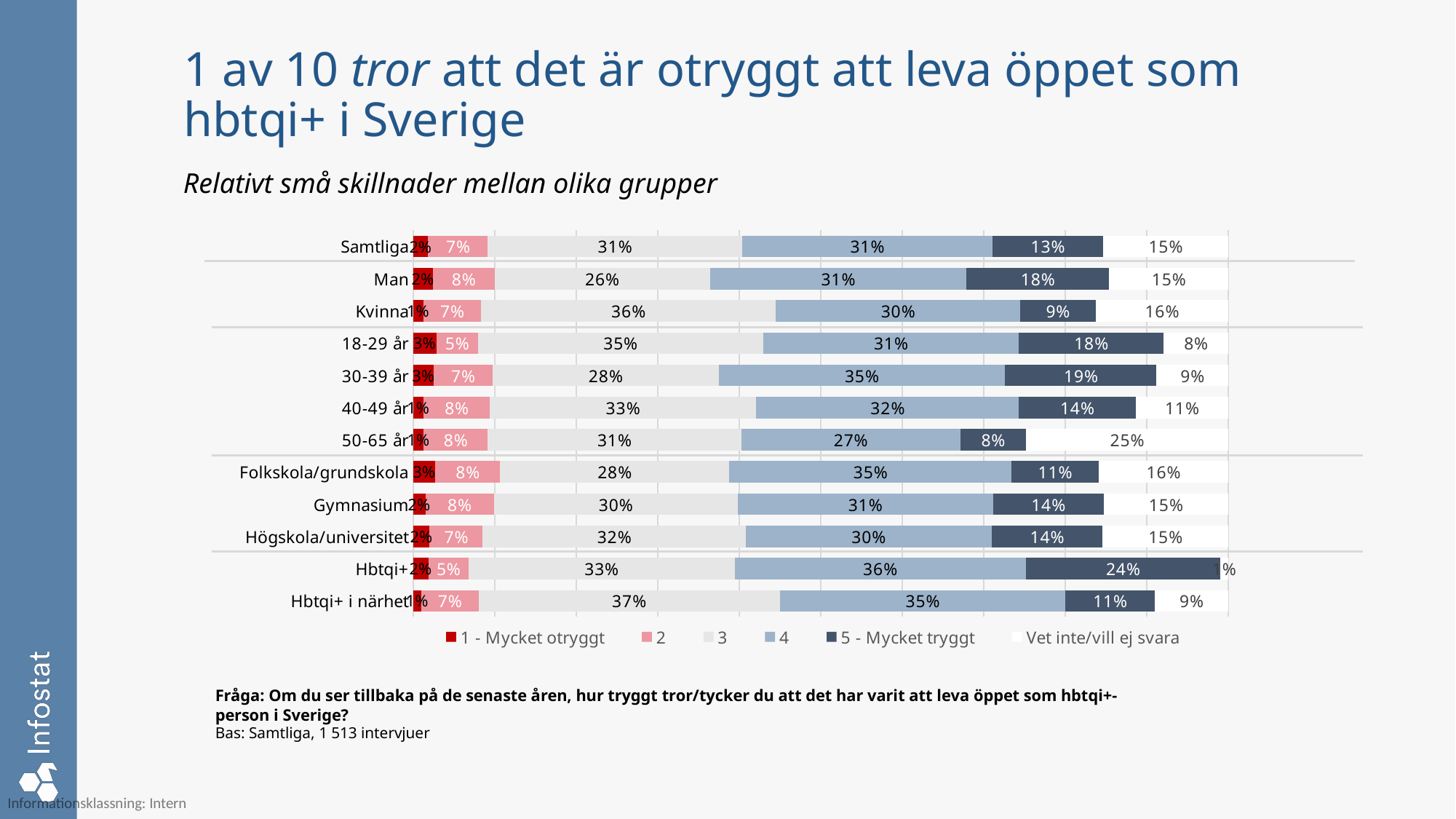
What kind of chart is shown on the slide? Stacked bar chart Which category has the highest value for series '3'? Hbtqi+ i närhet What is the value of '5 - Mycket tryggt' for Man? 18% What is the value of series '3' for Kvinna? 36% How many categories (rows) does the chart show? 12 Which is larger: the series '4' value for 30-39 år or for 50-65 år? 30-39 år What is the first entry in the legend? 1 - Mycket otryggt Which category has the highest value for '5 - Mycket tryggt'? Hbtqi+ What is the value of 'Vet inte/vill ej svara' for 50-65 år? 25% How many series does the legend list? 6 What is the difference between the '5 - Mycket tryggt' values for Man and Kvinna? 9% Which category has the lowest value for 'Vet inte/vill ej svara'? Hbtqi+